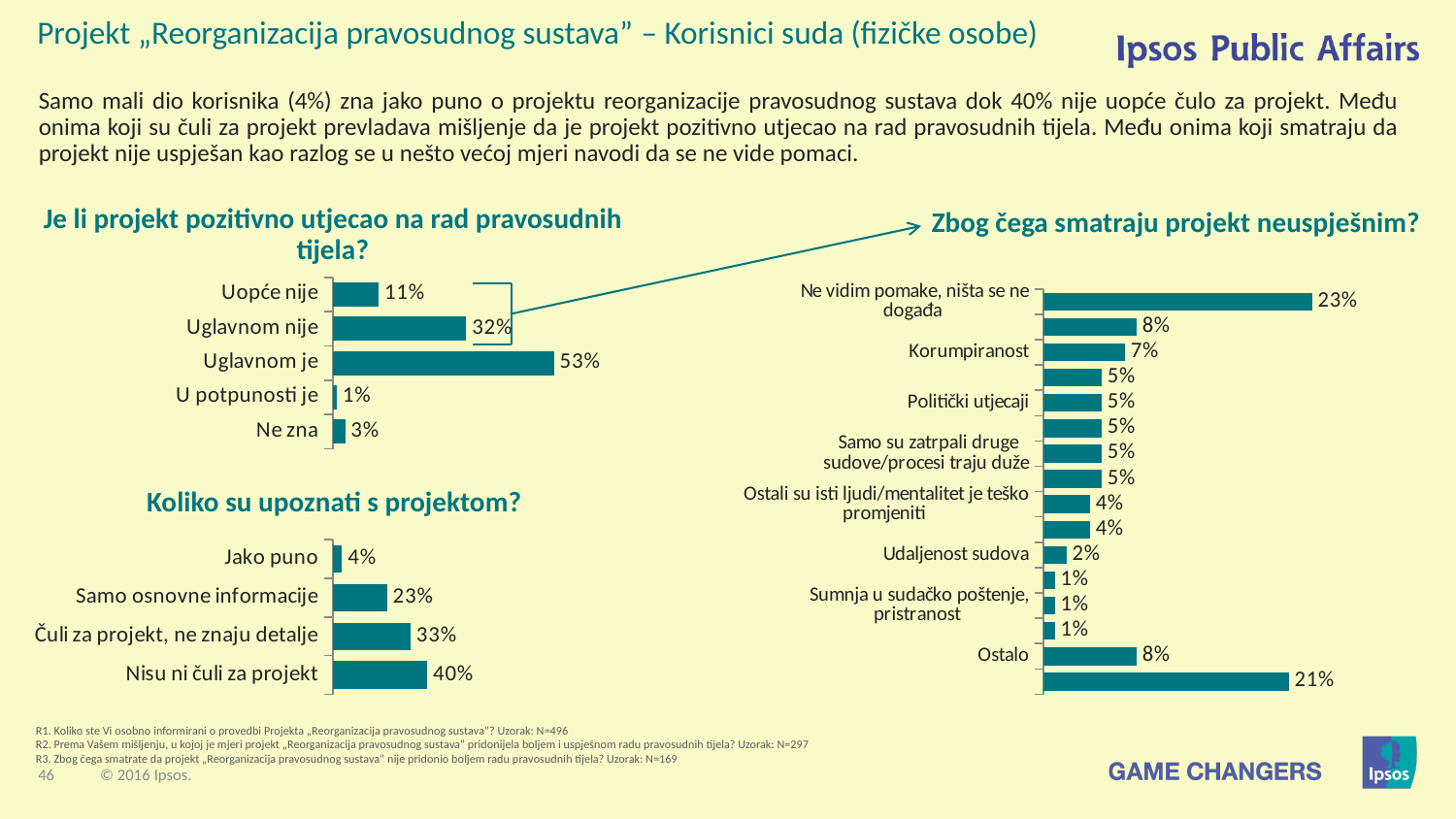
In the chart "Koliko su upoznati s projektom?", what is the value for "Nisu ni čuli za projekt"? 40% In the chart "Zbog čega smatraju projekt neuspješnim?", what is the value for "Korumpiranost"? 7% In the chart "Koliko su upoznati s projektom?", which category has the highest value? Nisu ni čuli za projekt In the chart "Je li projekt pozitivno utjecao na rad pravosudnih tijela?", what is the difference between "Uglavnom je" and "Uglavnom nije"? 21% In the chart "Zbog čega smatraju projekt neuspješnim?", what is the value for "Ne vidim pomake, ništa se ne događa"? 23% In the chart "Zbog čega smatraju projekt neuspješnim?", what is the value for "Udaljenost sudova"? 2% What type of chart is "Koliko su upoznati s projektom?"? Bar chart In the chart "Je li projekt pozitivno utjecao na rad pravosudnih tijela?", which category has the lowest value? U potpunosti je In the chart "Koliko su upoznati s projektom?", how many categories are shown? 4 In the chart "Je li projekt pozitivno utjecao na rad pravosudnih tijela?", what is the value for "Uglavnom je"? 53% In the chart "Je li projekt pozitivno utjecao na rad pravosudnih tijela?", how many categories are shown? 5 In the chart "Koliko su upoznati s projektom?", which is larger: "Samo osnovne informacije" or "Čuli za projekt, ne znaju detalje"? Čuli za projekt, ne znaju detalje